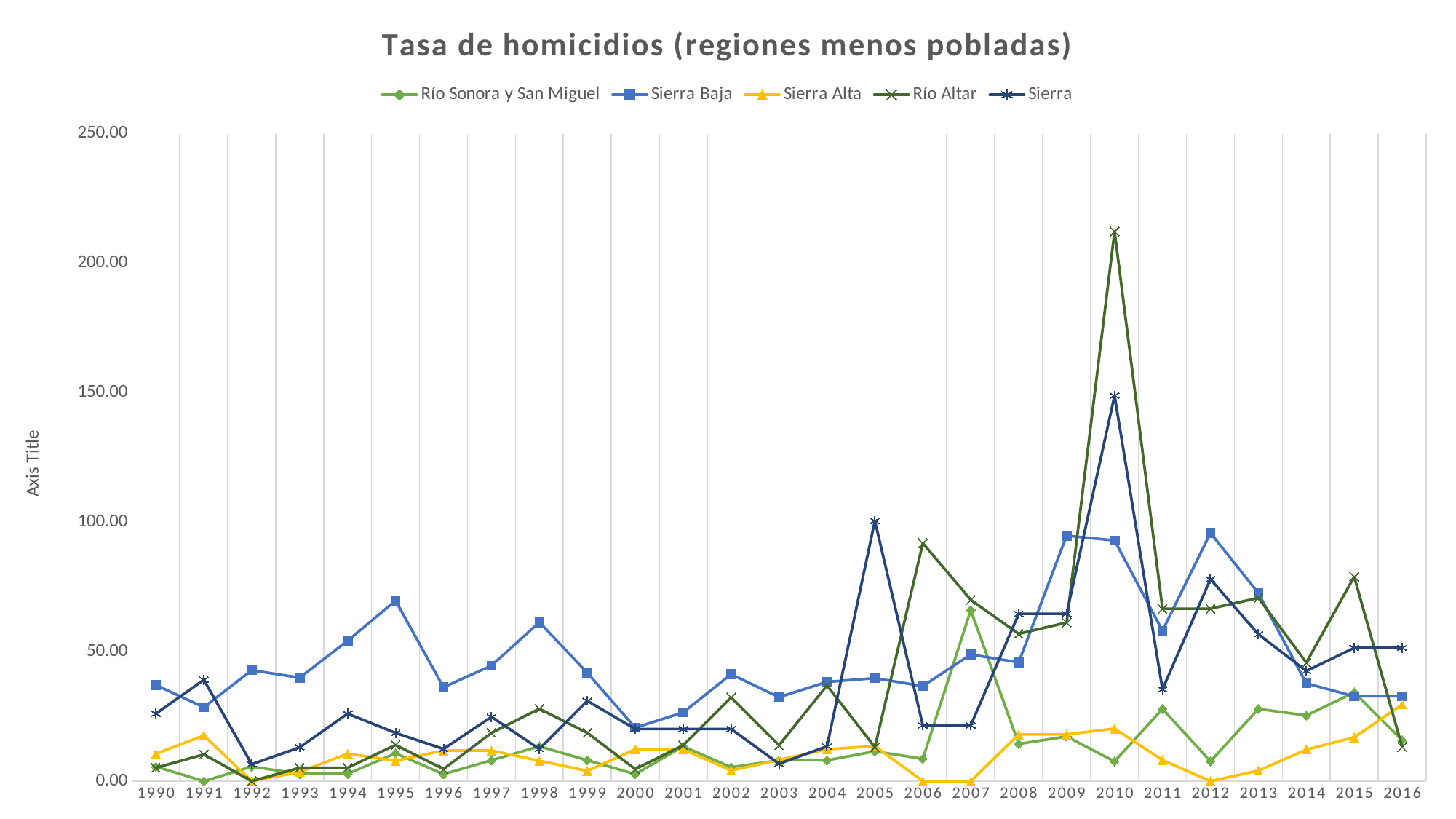
What is the title of the chart? Tasa de homicidios (regiones menos pobladas) Which series has the lowest value in 2012? Sierra Alta Is the value for Río Altar in 2010 greater or less than 200? greater In which year does the Río Altar series reach its highest value? 2010 In 2010, which is larger: Río Altar or Sierra Baja? Río Altar Does the Sierra Alta series rise or fall from 2012 to 2016? rise Is the value for Sierra Baja in 2009 greater or less than 50? greater In 2005, which is larger: Sierra or Sierra Baja? Sierra How many years are plotted along the x axis? 27 What type of chart is shown on the slide? line chart Which colour is used for the Sierra Alta series? yellow How many series does the legend list? 5